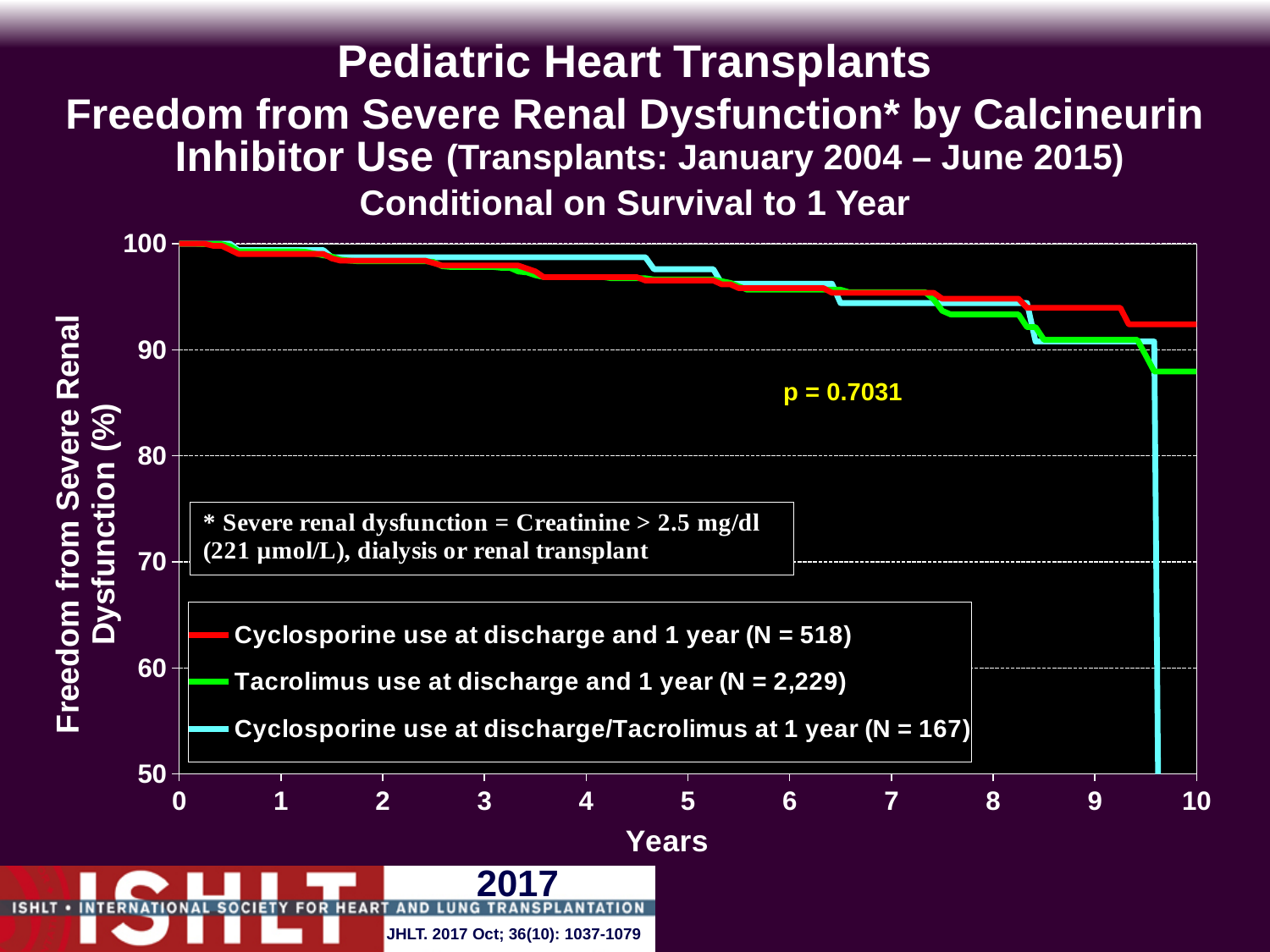
Is the value for Cyclosporine use at discharge/Tacrolimus at 1 year at 5 years greater or less than 90? greater How many series does the legend list? 3 Do the freedom from severe renal dysfunction curves rise or fall as years increase? Fall Is the value for Cyclosporine use at discharge and 1 year at 9 years greater or less than 90? greater What is the N for the Cyclosporine use at discharge/Tacrolimus at 1 year group? 167 What is the p-value printed on the chart? p = 0.7031 What kind of chart is shown on the slide? Line chart What is the label of the x axis? Years Is the value for Tacrolimus use at discharge and 1 year at 10 years greater or less than 90? less At 10 years, which is higher: the Cyclosporine use at discharge and 1 year curve or the Tacrolimus use at discharge and 1 year curve? Cyclosporine use at discharge and 1 year Which colour represents the Tacrolimus use at discharge and 1 year group? Green What is the N for the Tacrolimus use at discharge and 1 year group? 2,229